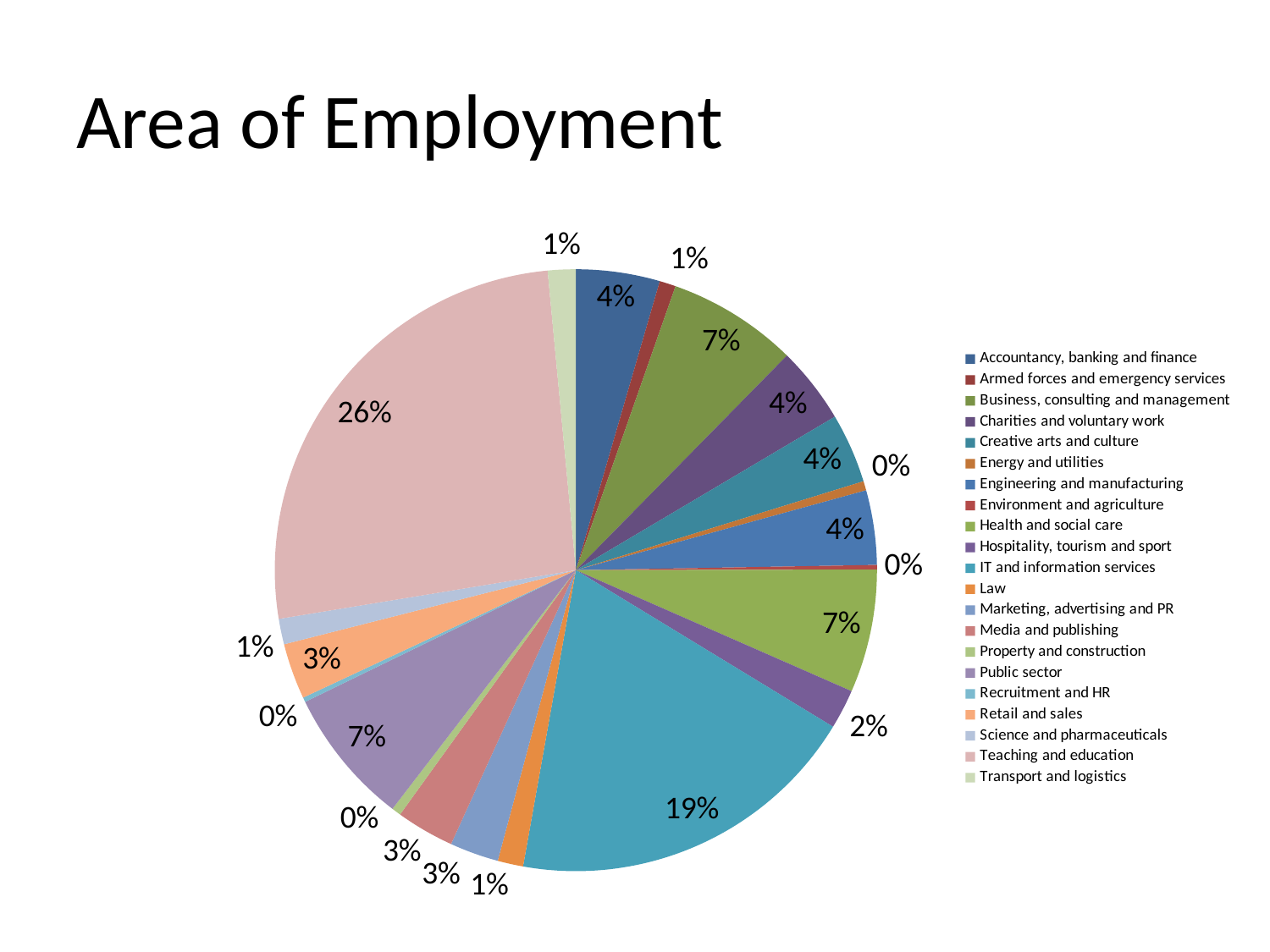
What is the share for Public sector? 7% What type of chart is shown on the slide? pie chart Which area of employment has the largest share of the pie? Teaching and education What percentage share does Teaching and education have? 26% What is the difference in percentage points between Teaching and education (26%) and IT and information services (19%)? 7 What is the share for Hospitality, tourism and sport? 2% What is the title of the chart? Area of Employment Which is larger, the share for Teaching and education or the share for IT and information services? Teaching and education What is the share for Accountancy, banking and finance? 4% What percentage share does IT and information services have? 19% How many categories does the legend list? 21 What is the share for Business, consulting and management? 7%